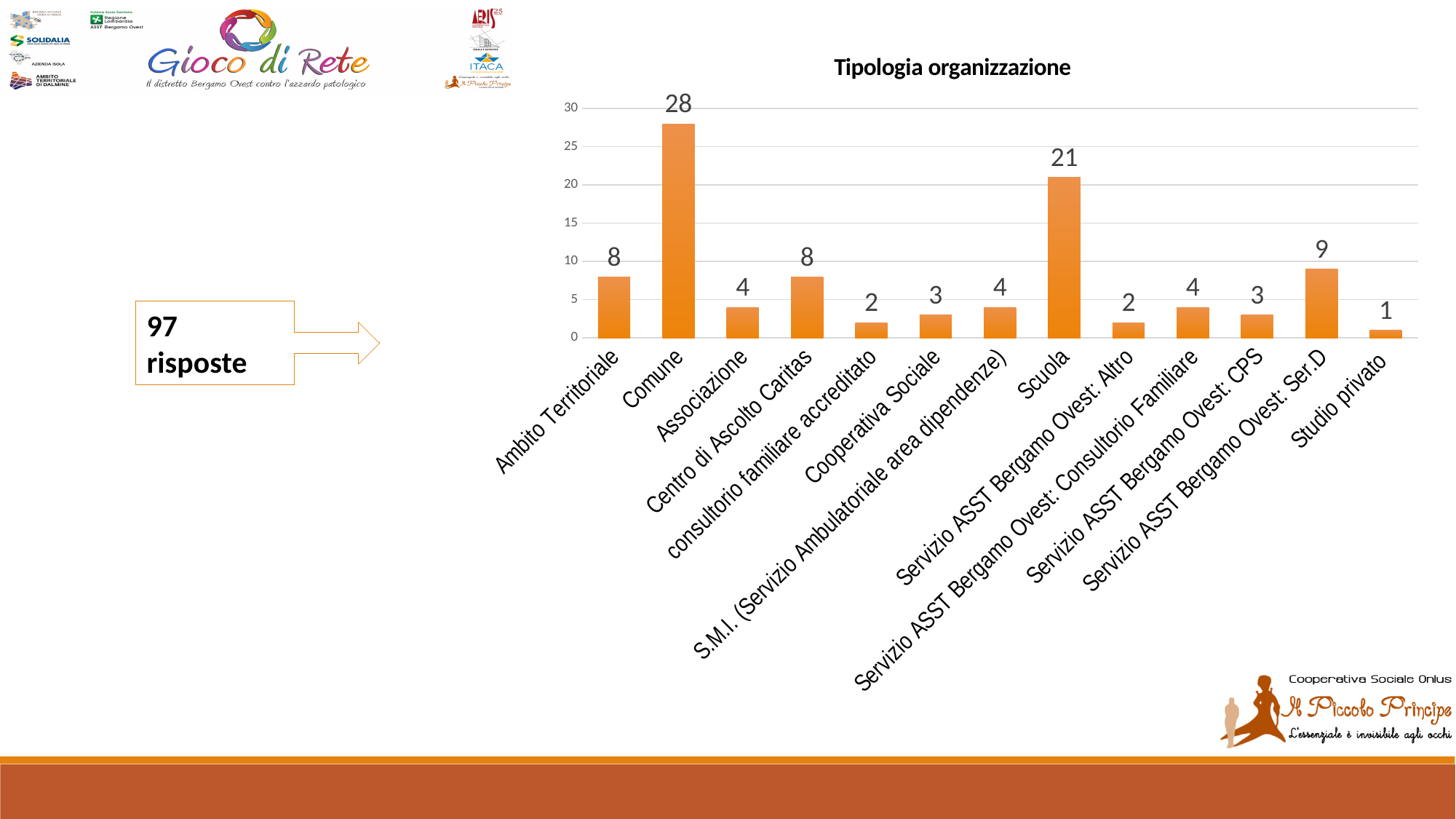
What is the title of the chart? Tipologia organizzazione What is the difference between the values for Comune and Scuola? 7 Which category has the highest value? Comune How many categories are shown on the x axis? 13 What is the value for Scuola? 21 What is the value for Servizio ASST Bergamo Ovest: Ser.D? 9 Which is larger, the value for Ambito Territoriale or the value for Associazione? Ambito Territoriale Which category has the lowest value? Studio privato What is the value for Comune? 28 What is the difference between the values for Servizio ASST Bergamo Ovest: Ser.D and Studio privato? 8 What kind of chart is shown? Bar chart What is the value for Cooperativa Sociale? 3